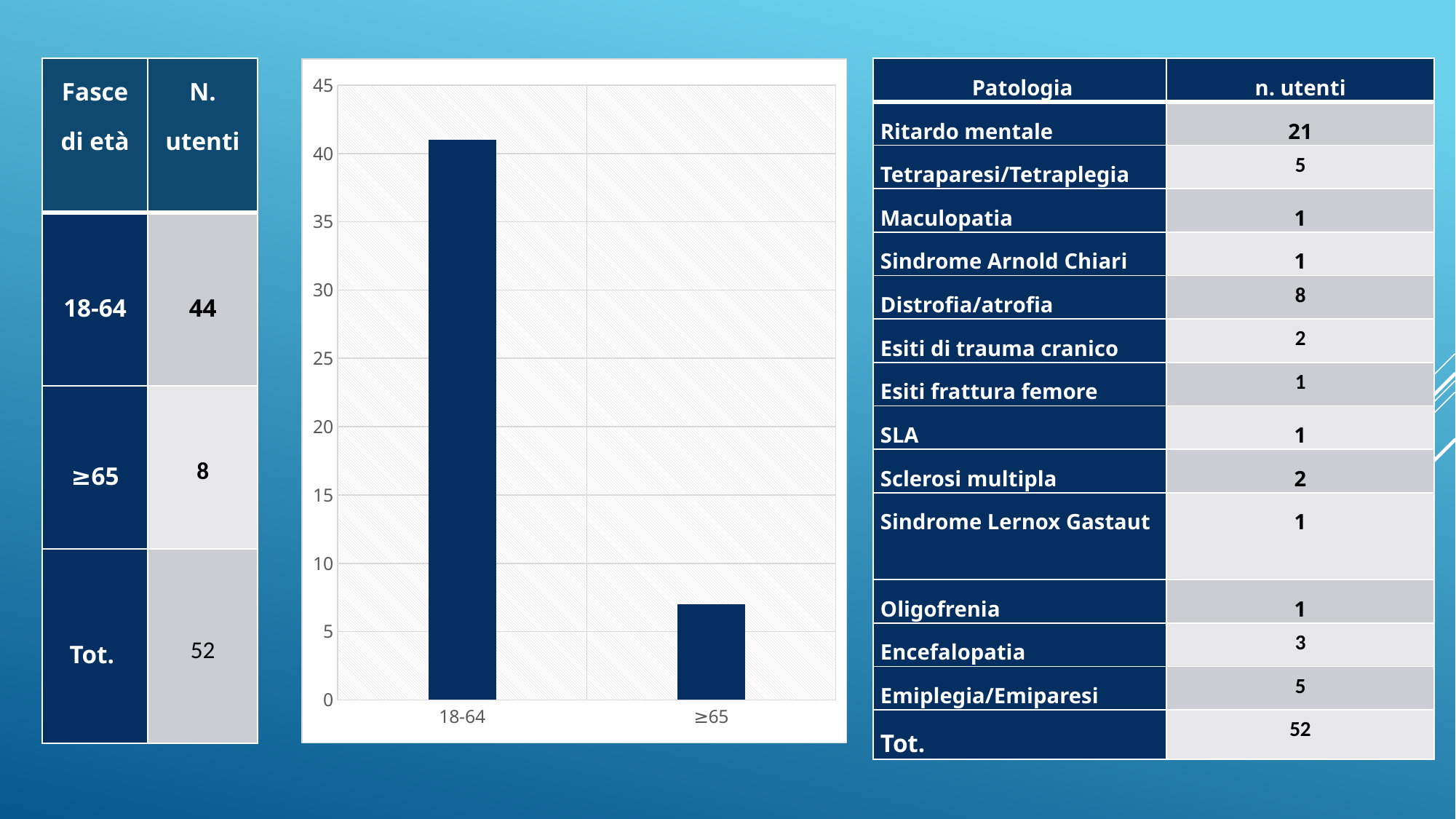
How many categories are plotted on the x axis of the chart? 2 Is the value for ≥65 greater or less than 5? greater Which category has the highest bar in the chart? 18-64 Is the value for ≥65 greater or less than 10? less What is the highest tick value shown on the chart's vertical axis? 45 What is the label of the first category on the chart's x axis? 18-64 Which category has the lowest bar in the chart? ≥65 Which bar is taller in the chart, 18-64 or ≥65? 18-64 Do the bar values rise or fall from 18-64 to ≥65 along the x axis? fall Is the value for 18-64 greater or less than 45? less What kind of chart is shown on the slide? bar chart